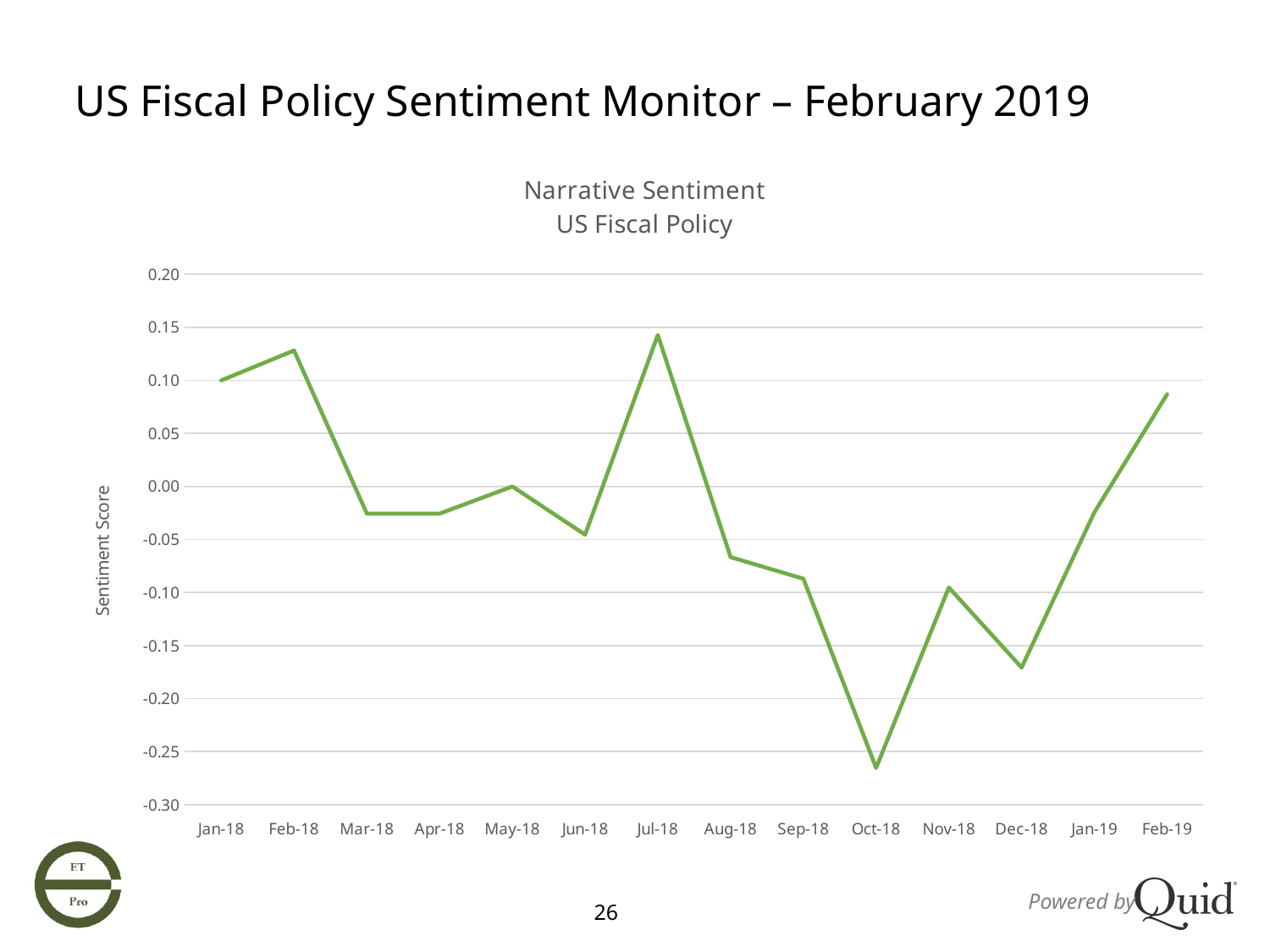
What kind of chart is shown on the slide? line chart Is the sentiment score for Feb-19 greater or less than 0.05? greater Which month has the highest sentiment score? Jul-18 Does the sentiment score rise or fall from Oct-18 to Feb-19 overall? rise How many monthly data points are plotted on the line? 14 Is the sentiment score for Jul-18 greater or less than 0.10? greater Is the sentiment score for Oct-18 greater or less than -0.25? less Which month has the lowest sentiment score? Oct-18 What is the sentiment score for May-18? 0.00 What is the label on the vertical axis of the chart? Sentiment Score Which has the higher sentiment score, Jan-18 or Dec-18? Jan-18